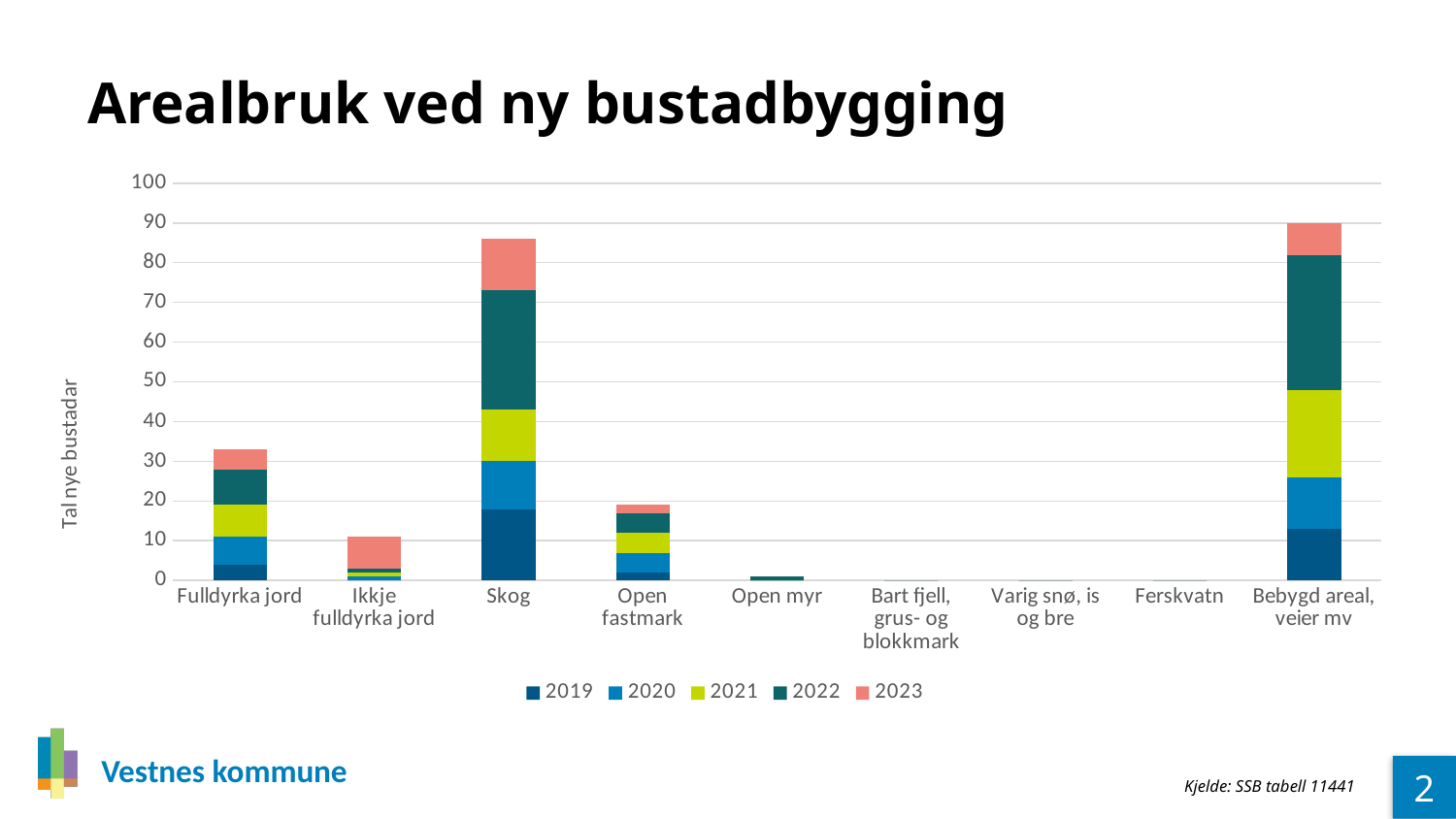
What kind of chart is shown on the slide? Stacked bar chart Is the total stacked value for Open fastmark greater or less than 10? greater Is the total stacked value for Bebygd areal, veier mv greater or less than 80? greater How many series does the chart's legend list? 5 How many categories are shown on the x axis of the chart? 9 Is the total stacked value for Fulldyrka jord greater or less than 30? greater Which has the larger total stacked value, Open fastmark or Ikkje fulldyrka jord? Open fastmark What is the label on the vertical axis of the chart? Tal nye bustadar What is the title of the chart on the slide? Arealbruk ved ny bustadbygging Which has the larger total stacked value, Skog or Fulldyrka jord? Skog